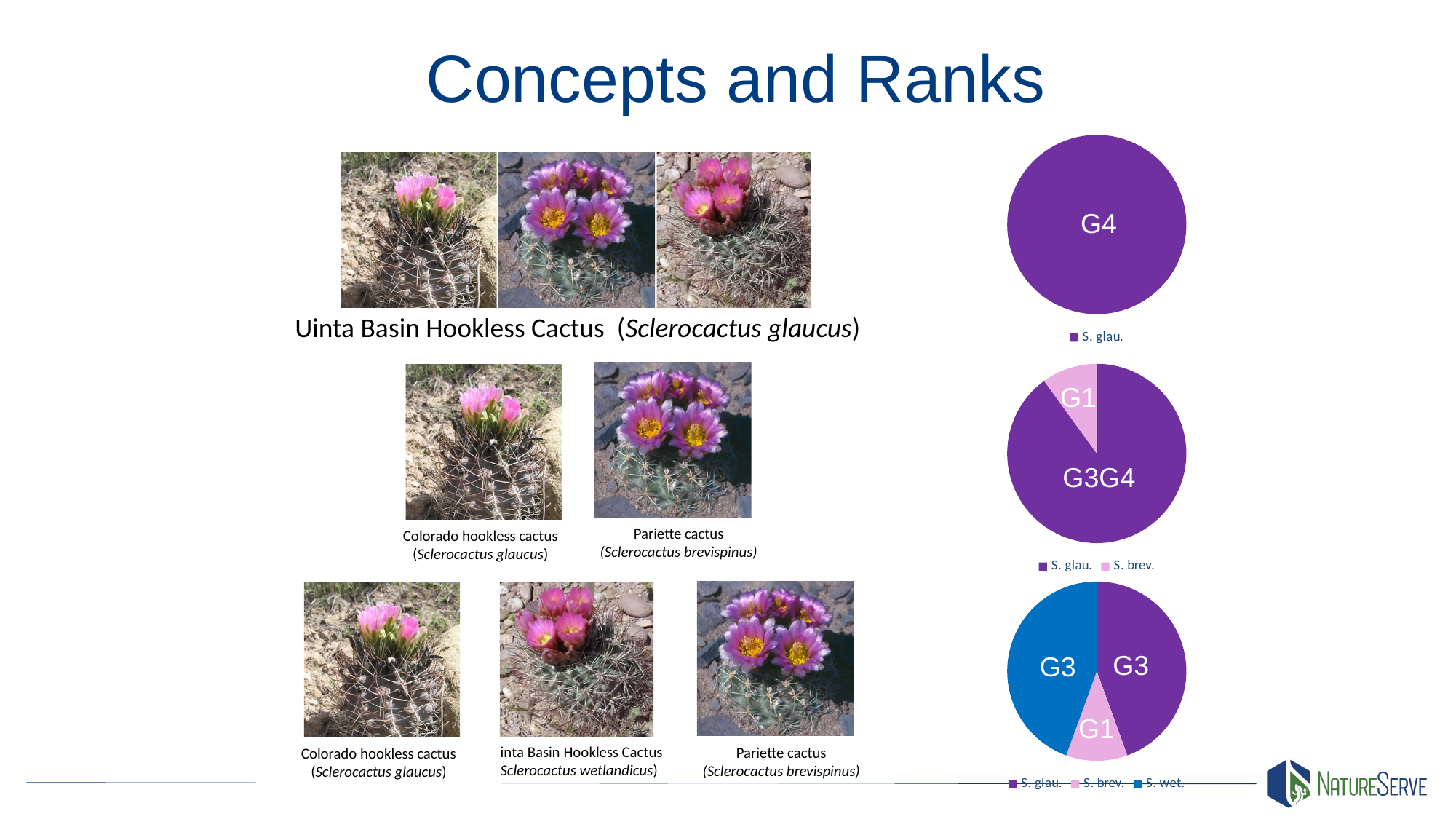
In the middle pie chart, which legend entry has the smallest slice? S. brev. How many entries does the legend of the bottom pie chart list? 3 In the bottom pie chart, what colour is the S. wet. slice? blue In the middle pie chart, what label is printed on the S. brev. slice? G1 In the middle pie chart, which legend entry has the largest slice? S. glau. How many slices does the bottom pie chart have? 3 What label is printed inside the top pie chart? G4 How many slices does the middle pie chart have? 2 How many entries does the legend of the top pie chart list? 1 How many entries does the legend of the middle pie chart list? 2 What kind of chart is the top chart on the right side of the slide? pie chart In the bottom pie chart, which legend entry has the smallest slice? S. brev.